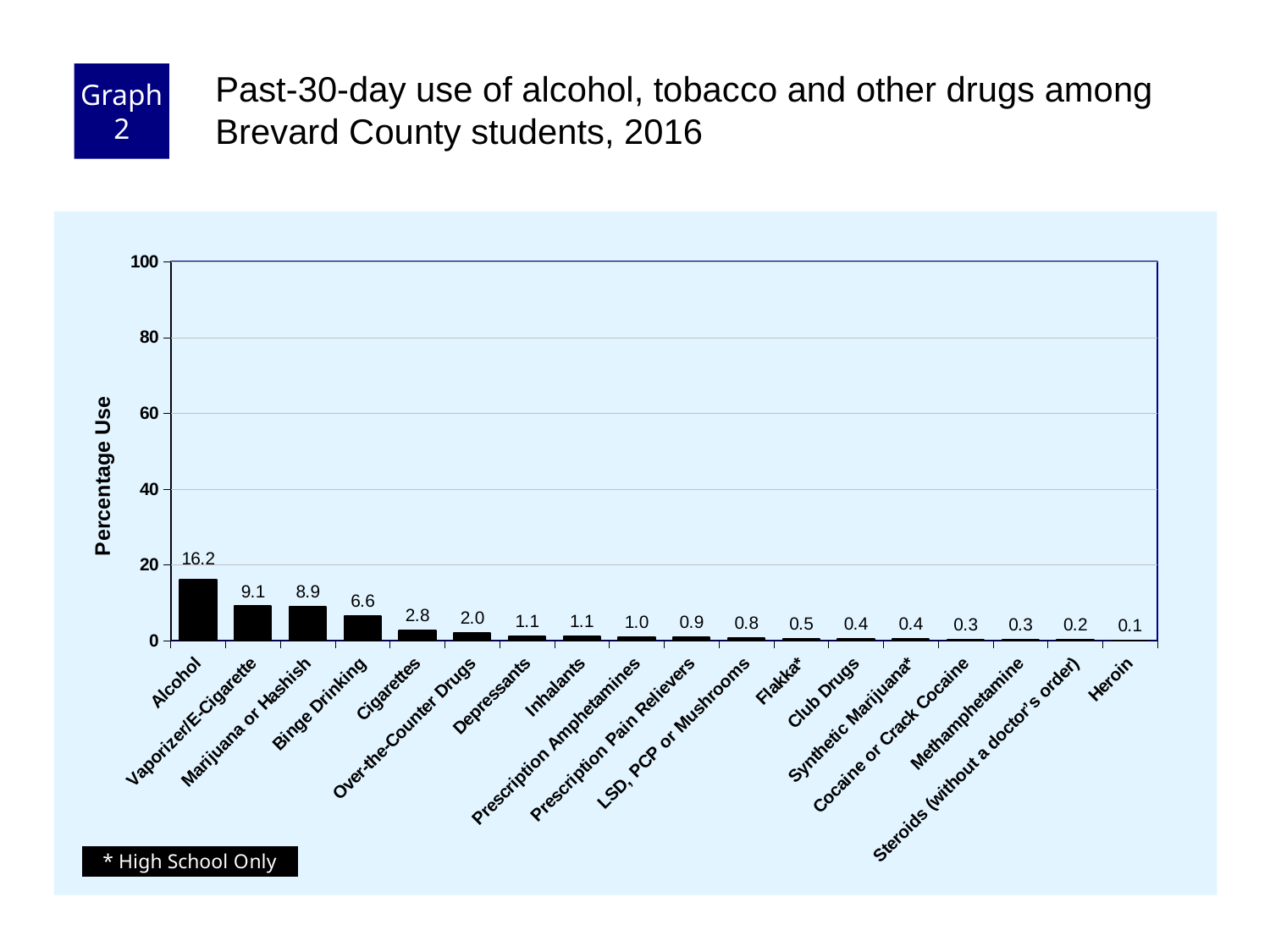
What is the percentage use for Binge Drinking? 6.6 Is the value for Alcohol greater or less than 20? less What is the percentage use for Cigarettes? 2.8 What is the percentage use for Alcohol? 16.2 What is the percentage use for Vaporizer/E-Cigarette? 9.1 What kind of chart is shown on the slide? bar chart What is the difference in percentage use between Alcohol and Marijuana or Hashish? 7.3 Which has a higher percentage use, Cigarettes or Over-the-Counter Drugs? Cigarettes Which category has the highest percentage use? Alcohol What is the label of the y axis? Percentage Use How many categories are shown on the x axis? 18 Which category has the lowest percentage use? Heroin